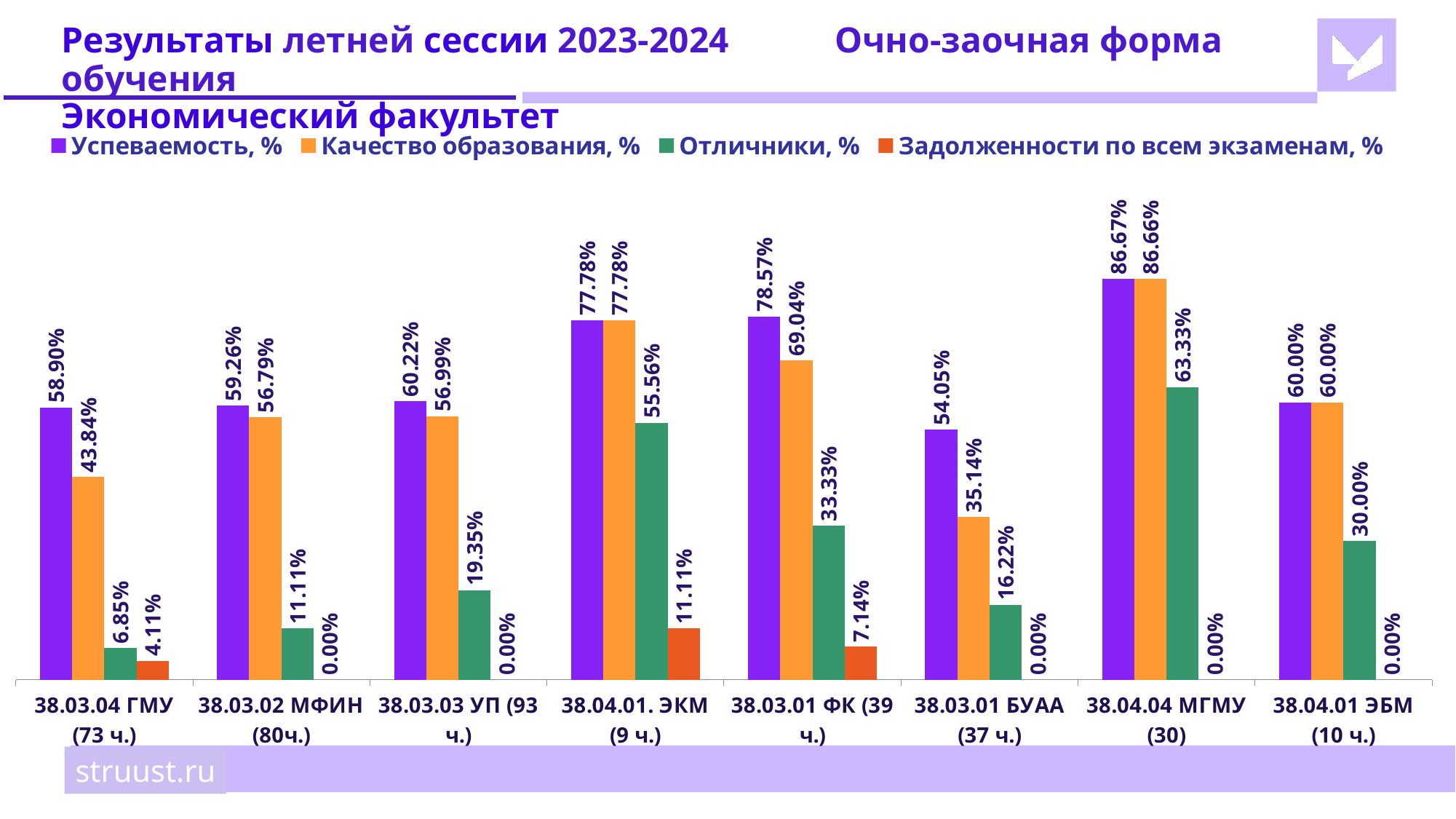
Which category has the highest Успеваемость, % value? 38.04.04 МГМУ (30) What is the Задолженности по всем экзаменам, % value for 38.04.01. ЭКМ (9 ч.)? 11.11% What is the difference between the Успеваемость, % and Качество образования, % values for 38.03.01 ФК (39 ч.)? 9.53% What kind of chart is shown on the slide? Bar chart Which category has the lowest Отличники, % value? 38.03.04 ГМУ (73 ч.) What is the Успеваемость, % value for 38.04.04 МГМУ (30)? 86.67% How many series does the legend list? 4 How many categories are shown on the x axis? 8 Which colour represents the Задолженности по всем экзаменам, % series in the legend? Red-orange What is the Качество образования, % value for 38.03.04 ГМУ (73 ч.)? 43.84% Which is larger: the Отличники, % value for 38.03.03 УП (93 ч.) or for 38.03.01 БУАА (37 ч.)? 38.03.03 УП (93 ч.) What is the Отличники, % value for 38.03.01 ФК (39 ч.)? 33.33%